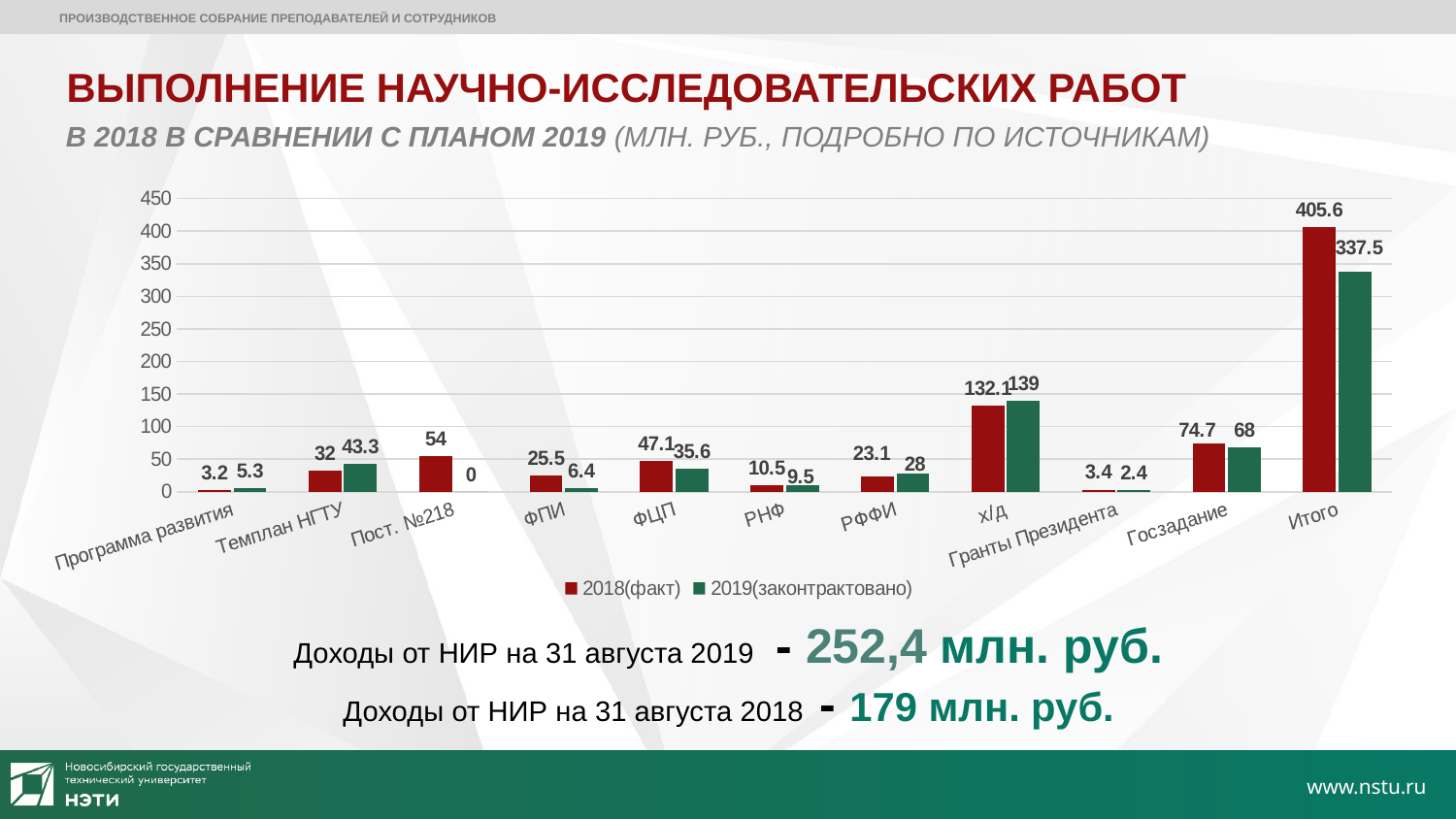
What is the difference between the 2018(факт) and 2019(законтрактовано) values for Итого? 68.1 Which category has the highest 2019(законтрактовано) value? Итого Which category has the lowest 2019(законтрактовано) value? Пост. №218 How many series does the legend list? 2 What type of chart is shown on the slide? bar chart What is the 2019(законтрактовано) value for х/д? 139 How many categories are shown on the x axis? 11 Which is larger for Темплан НГТУ: the 2018(факт) value or the 2019(законтрактовано) value? 2019(законтрактовано) What is the 2018(факт) value for Госзадание? 74.7 What is the 2018(факт) value for Пост. №218? 54 Is the 2018(факт) value for х/д greater or less than 100? greater What colour are the bars for the 2018(факт) series? dark red